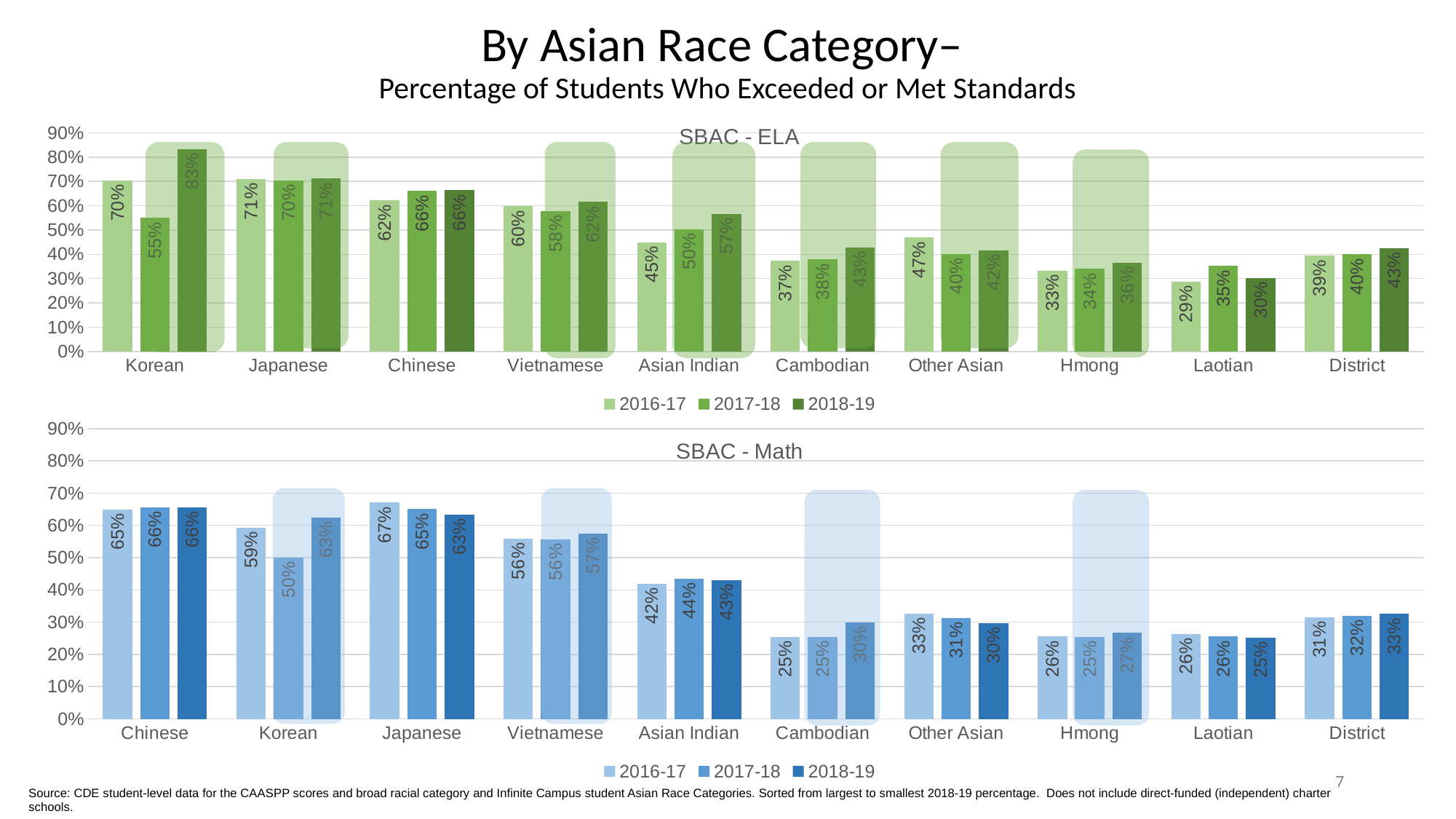
In the SBAC - Math chart, what is the value for Japanese in 2016-17? 67% In the SBAC - Math chart, what is the difference between the 2018-19 and 2016-17 values for Korean? 4% What kind of chart is the SBAC - Math chart? bar chart How many series does the legend of the SBAC - ELA chart list? 3 In the SBAC - Math chart, which category has the lowest 2016-17 value? Cambodian In the SBAC - Math chart, is the 2018-19 value for Cambodian greater or less than 40%? less In the SBAC - ELA chart, which is larger for Laotian: the 2017-18 value or the 2018-19 value? 2017-18 In the SBAC - ELA chart, what is the value for Korean in 2018-19? 83% In the SBAC - ELA chart, what is the difference between the 2018-19 and 2017-18 values for Korean? 28% In the SBAC - ELA chart, do the 2018-19 values for Hmong rise or fall from 2016-17 to 2018-19? rise In the SBAC - ELA chart, which category has the highest 2018-19 value? Korean How many categories are shown on the x axis of the SBAC - Math chart? 10